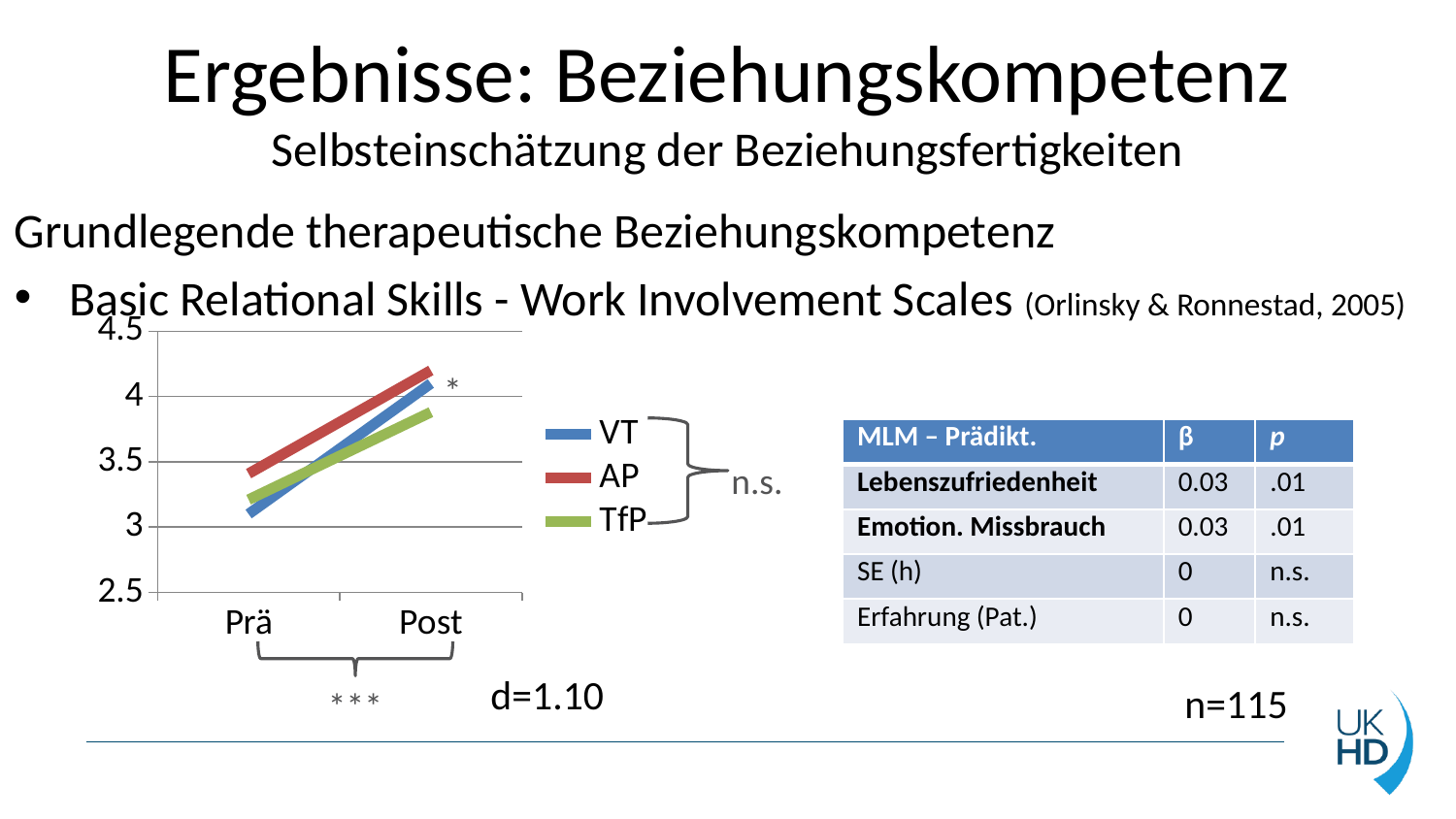
What colour is the AP line in the chart? red What kind of chart is shown on the slide? line chart At Post, which is larger: the value for AP or the value for TfP? AP How many series does the chart legend list? 3 At Prä, which is larger: the value for AP or the value for VT? AP Which series has the highest value at Post? AP Do the values for VT rise or fall from Prä to Post? rise How many categories are shown on the x axis of the chart? 2 Is the value for AP at Post greater or less than 4? greater Is the value for TfP at Prä greater or less than 3.5? less Which series has the lowest value at Post? TfP Is the value for VT at Prä greater or less than 3? greater